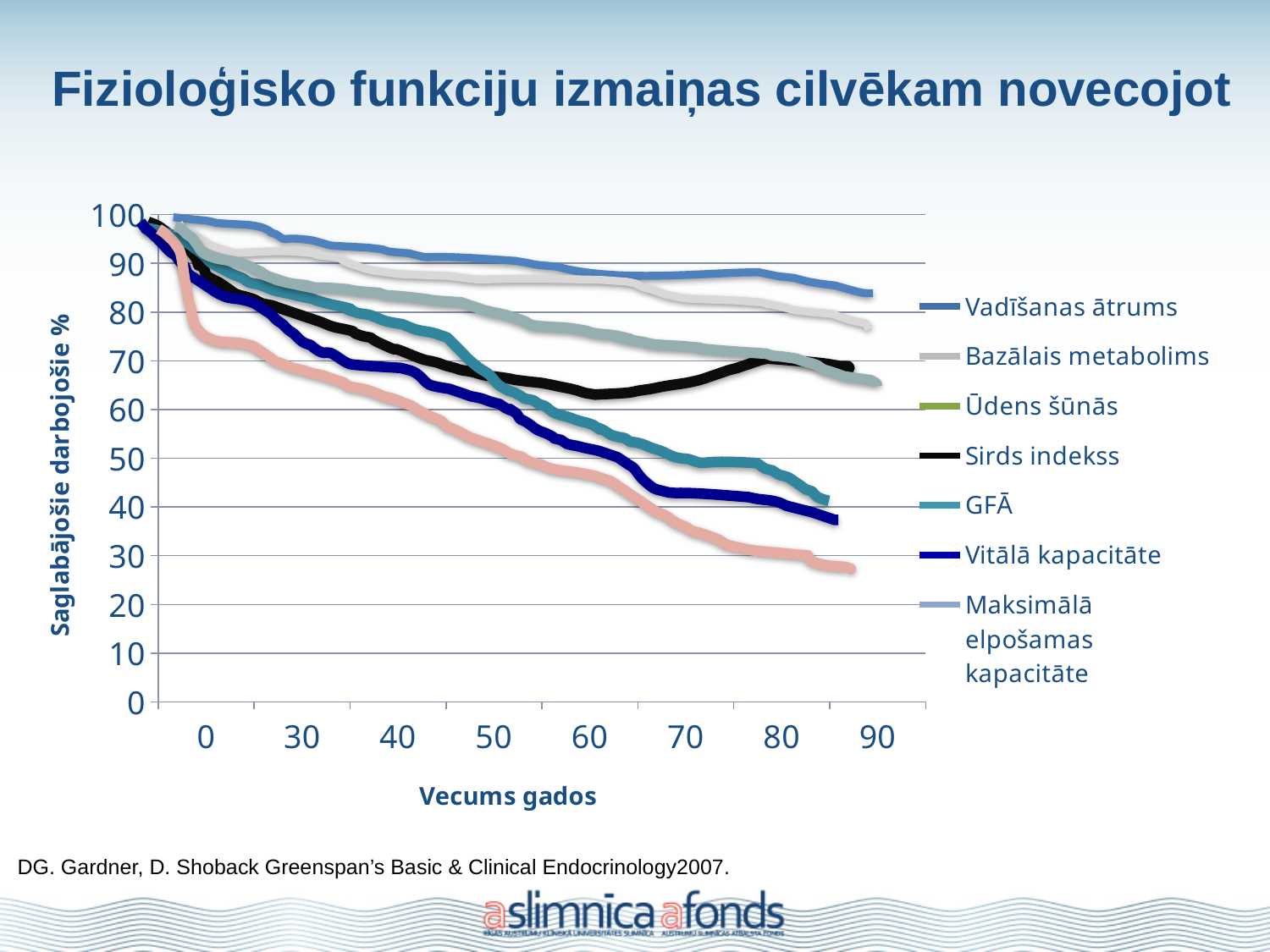
Which series has the highest value at the right end of the chart (around age 90)? Vadīšanas ātrums Do the values for Vadīšanas ātrums rise or fall as age increases along the x axis? fall At age 90, which is larger: the value for Vadīšanas ātrums or the value for Vitālā kapacitāte? Vadīšanas ātrums Is the value for Maksimālā elpošamas kapacitāte at age 90 greater or less than 40? greater How many series does the legend list? 7 Is the value for GFĀ at age 80 greater or less than 60? less What is the title of the chart on the slide? Fizioloģisko funkciju izmaiņas cilvēkam novecojot What is the label of the x axis? Vecums gados Do the values for Maksimālā elpošamas kapacitāte rise or fall as age increases? fall Is the value for Vadīšanas ātrums at age 90 greater or less than 80? greater What kind of chart is shown on the slide? line chart Which series has the lowest value at the right end of the chart (around age 90)? Ūdens šūnās